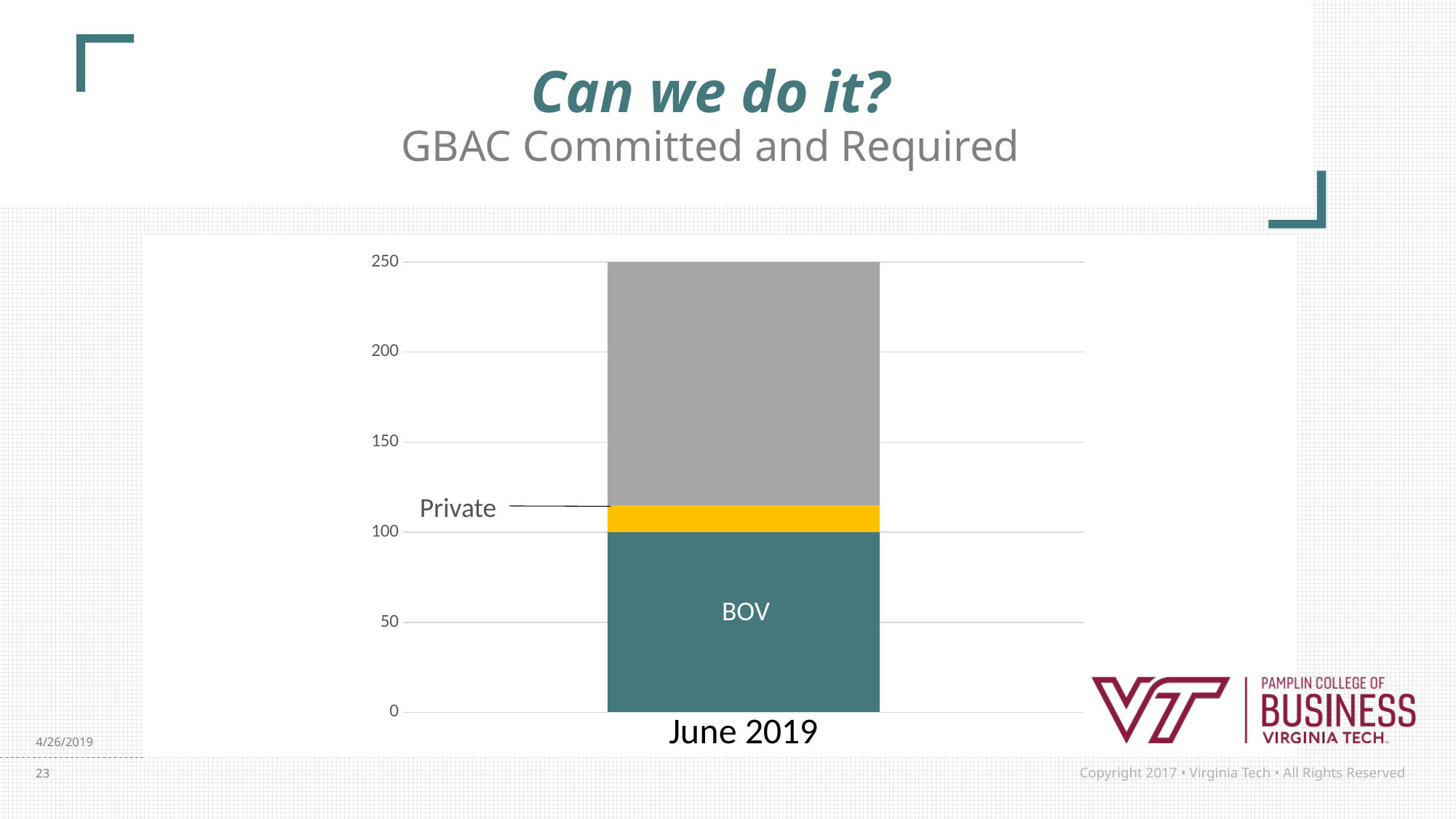
Is the top of the Private segment in the June 2019 bar greater or less than 150 on the axis? less Is the top of the Private segment in the June 2019 bar greater or less than 100 on the axis? greater What is the value of the BOV segment in the June 2019 bar? 100 Which category label appears on the x axis of the chart? June 2019 How many categories are shown on the x axis of the chart? 1 Which is larger in the June 2019 bar, the BOV segment or the Private segment? BOV What is the total height of the stacked bar for June 2019? 250 Is the value of the Private segment in the June 2019 bar greater or less than 50? less What kind of chart is shown on the slide? bar chart What is the highest value shown on the vertical axis of the chart? 250